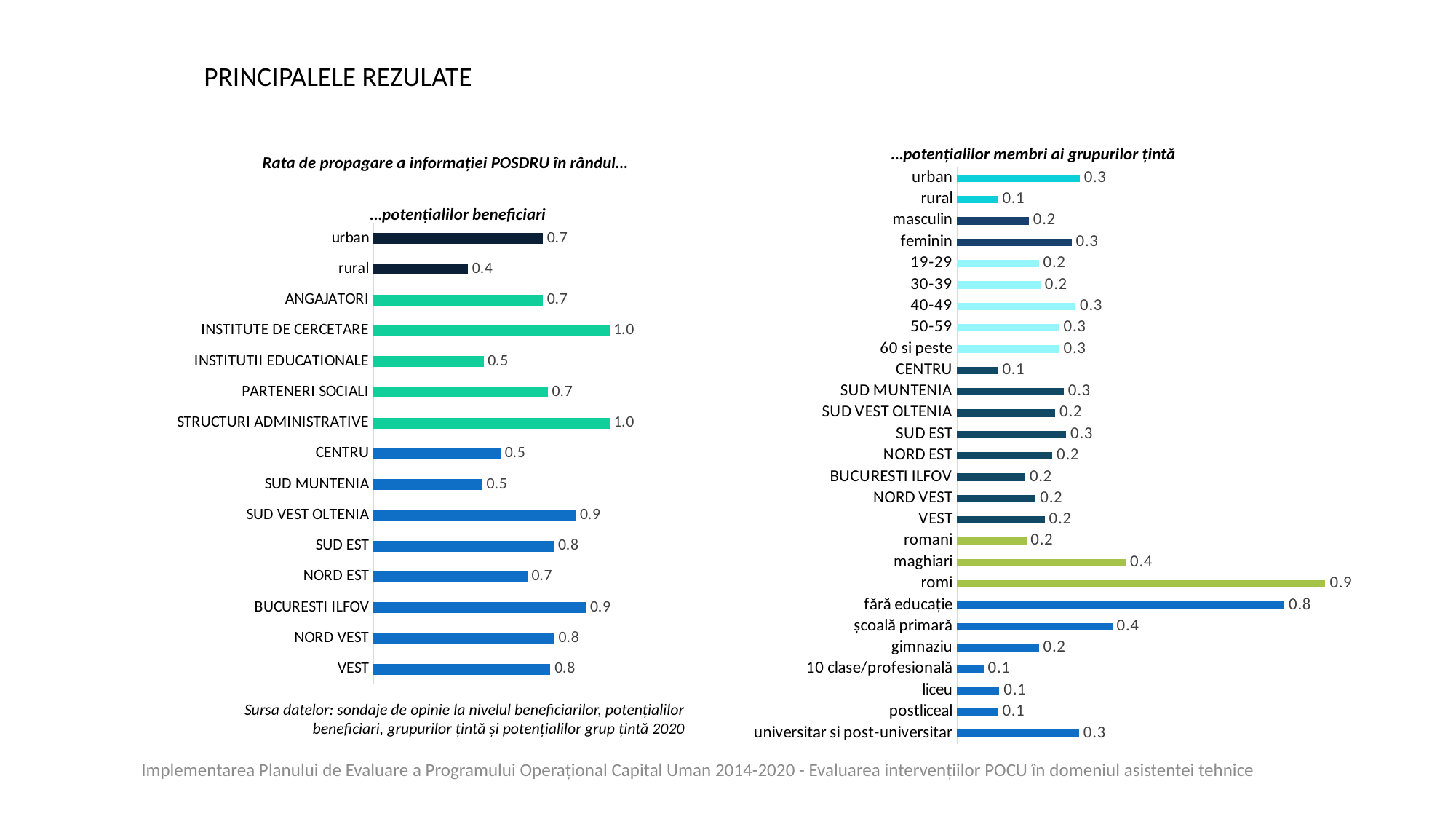
In the chart '...potențialilor membri ai grupurilor țintă', what is the value for romi? 0.9 In the chart '...potențialilor membri ai grupurilor țintă', which is larger, feminin or masculin? feminin In the chart '...potențialilor beneficiari', which category has the lowest value? rural In the chart '...potențialilor beneficiari', what is the value for INSTITUTE DE CERCETARE? 1.0 How many categories are plotted in the chart '...potențialilor beneficiari'? 15 In the chart '...potențialilor beneficiari', what is the difference between SUD VEST OLTENIA and SUD MUNTENIA? 0.4 In the chart '...potențialilor beneficiari', what is the value for rural? 0.4 In the chart '...potențialilor membri ai grupurilor țintă', what is the difference between maghiari and romani? 0.2 What type of chart is used for '...potențialilor membri ai grupurilor țintă'? Bar chart In the chart '...potențialilor membri ai grupurilor țintă', which category has the highest value? romi In the chart '...potențialilor beneficiari', which is larger, BUCURESTI ILFOV or NORD EST? BUCURESTI ILFOV In the chart '...potențialilor membri ai grupurilor țintă', what is the value for fără educație? 0.8